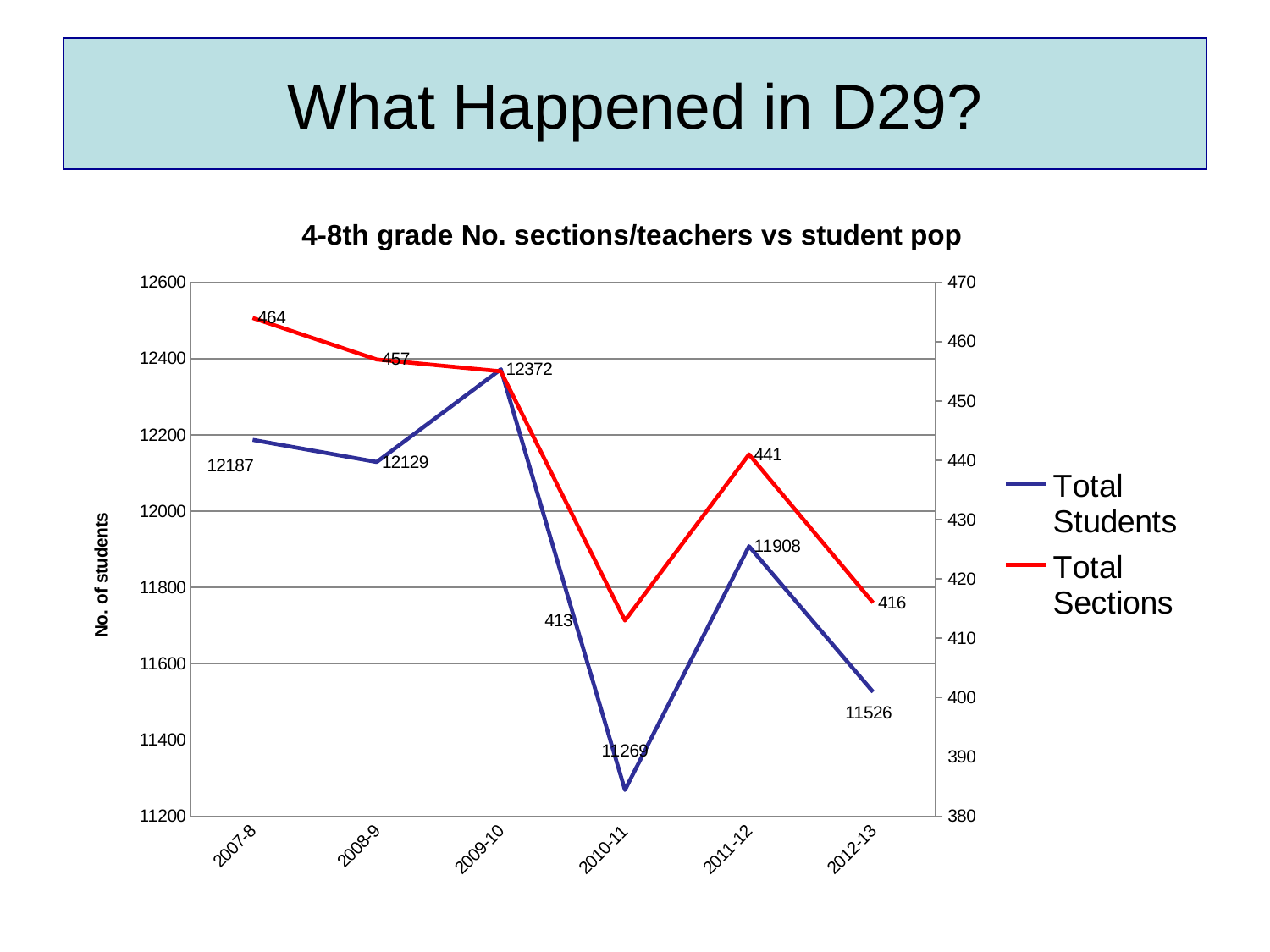
Which year has more Total Sections, 2011-12 or 2012-13? 2011-12 In which year is Total Students highest? 2009-10 What is the difference between Total Students in 2009-10 and 2010-11? 1103 What is the value of Total Students for 2010-11? 11269 Is the value of Total Sections for 2009-10 greater or less than 450? greater How many series does the legend list? 2 What is the value of Total Sections for 2007-8? 464 In which year is Total Students lowest? 2010-11 In which year is Total Sections lowest? 2010-11 How many school years are shown on the x axis? 6 What is the value of Total Students for 2012-13? 11526 What kind of chart is shown on the slide? line chart